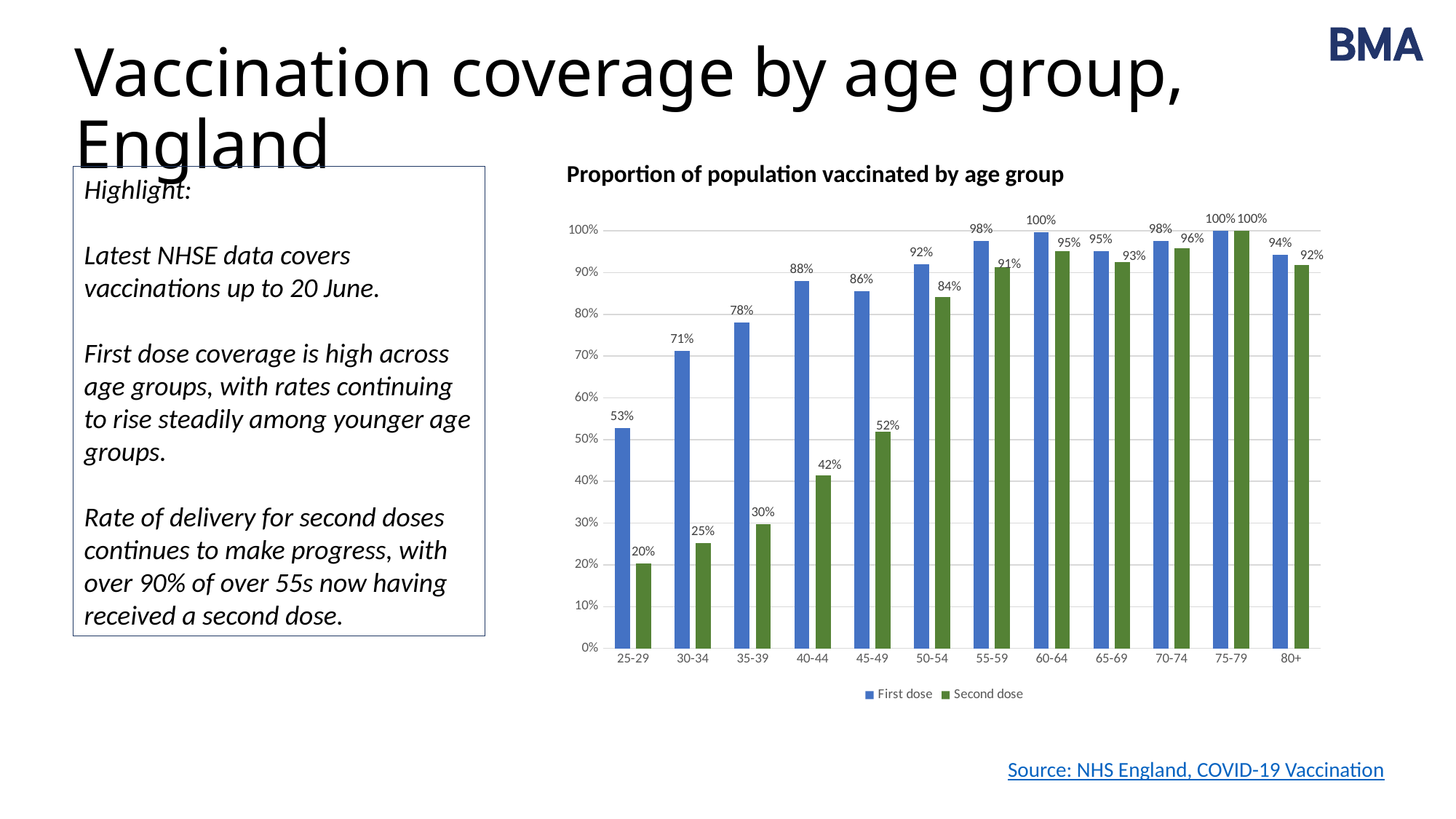
What is the second dose value for the 45-49 age group? 52% How many series does the legend list? 2 Which age group has the highest second dose coverage? 75-79 Which age group has the higher first dose value, 40-44 or 45-49? 40-44 What is the title of the chart? Proportion of population vaccinated by age group What is the first dose value for the 40-44 age group? 88% What is the difference between the first dose and second dose values for the 25-29 age group? 33 percentage points Which age group has the lowest second dose coverage? 25-29 What is the second dose value for the 70-74 age group? 96% Do the second dose values rise or fall from the 25-29 group to the 50-54 group? Rise How many age groups are shown on the x axis? 12 What kind of chart is shown on the slide? Bar chart